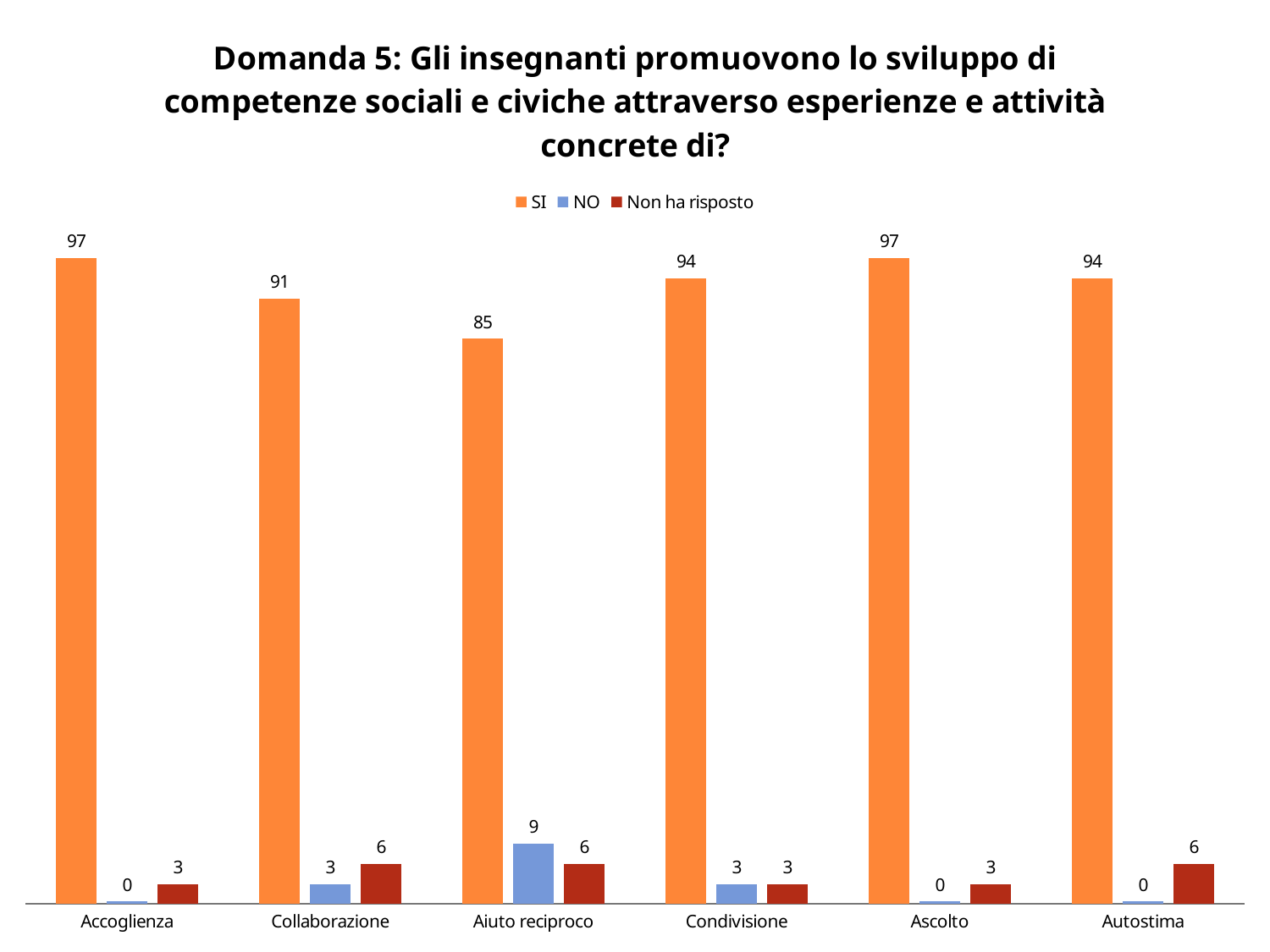
Which series is shown in orange? SI What kind of chart is shown on the slide? bar chart What is the NO value for Aiuto reciproco? 9 What is the SI value for Condivisione? 94 What is the SI value for Aiuto reciproco? 85 Which category has the highest NO value? Aiuto reciproco How many categories are shown on the x axis? 6 What is the Non ha risposto value for Collaborazione? 6 How many series does the legend list? 3 What is the difference between the SI values for Accoglienza and Aiuto reciproco? 12 Which category has the lowest SI value? Aiuto reciproco Which is larger, the SI value for Collaborazione or the SI value for Autostima? Autostima